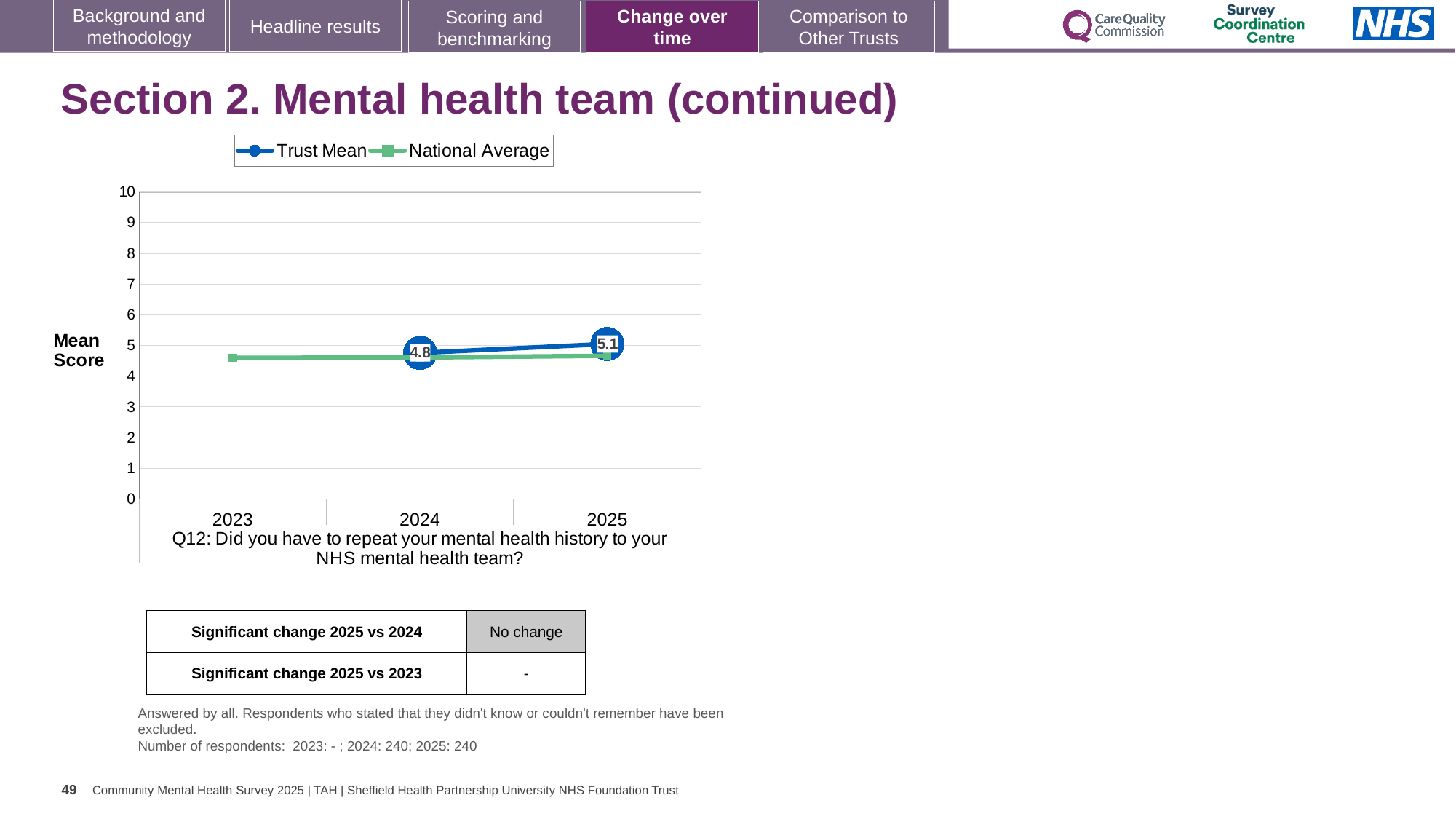
How many years are shown on the x axis? 3 Is the National Average value for 2023 greater or less than 5? less How many series does the legend list? 2 What is the Trust Mean value for 2025? 5.1 What is the label on the y axis of the chart? Mean Score Which year has the higher Trust Mean, 2024 or 2025? 2025 What are the two series named in the legend? Trust Mean and National Average What is the Trust Mean value for 2024? 4.8 Does the Trust Mean rise or fall from 2024 to 2025? rise Is the Trust Mean value for 2025 greater or less than 5? greater By how much did the Trust Mean change from 2024 to 2025? 0.3 What kind of chart is shown on the slide? line chart